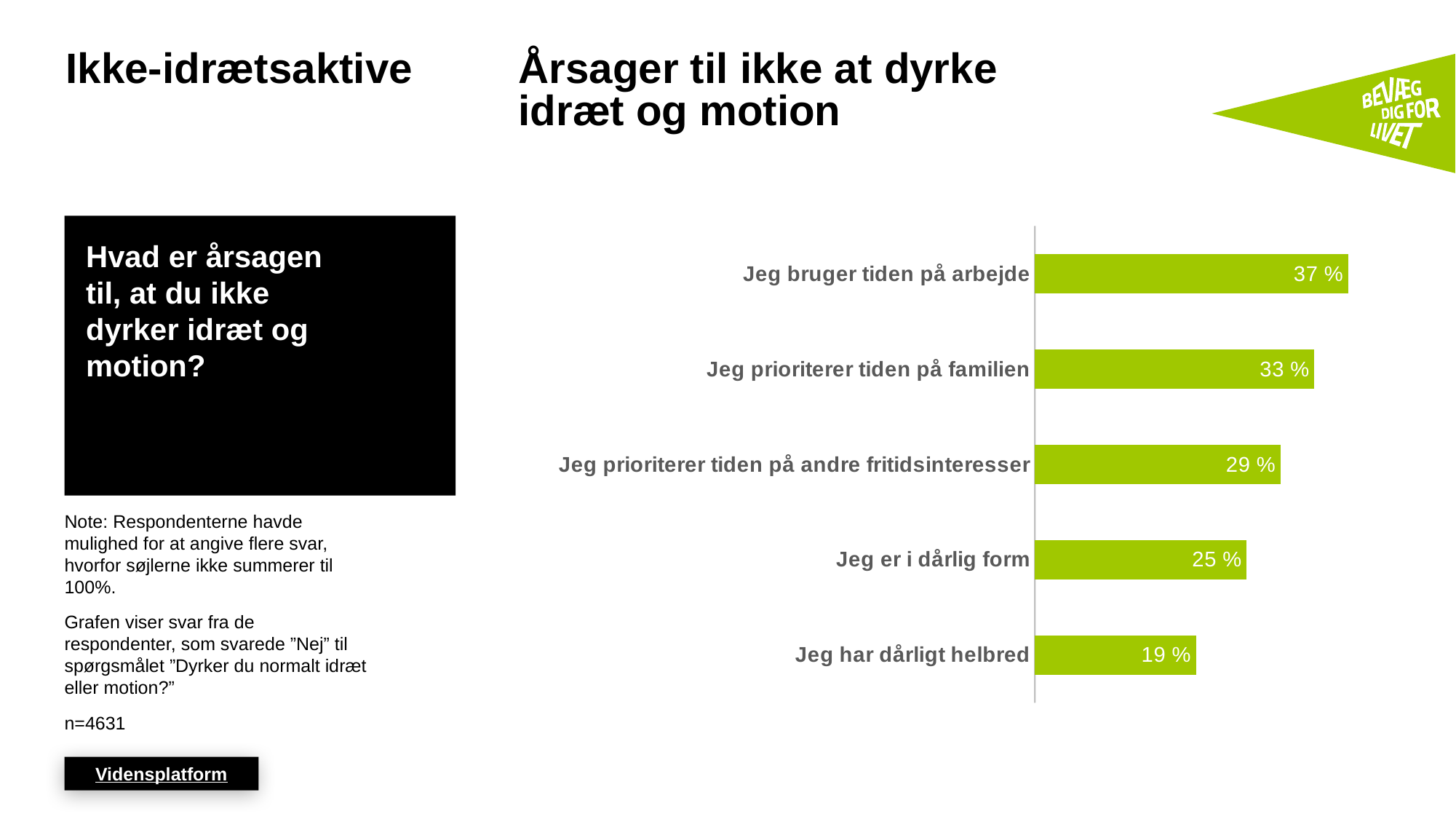
What colour are the bars in the chart? Green How many reasons (categories) are shown in the chart? 5 What is the value for "Jeg har dårligt helbred"? 19 % What is the difference between the highest and lowest values in the chart? 18 % Which reason has the lowest percentage? Jeg har dårligt helbred What is the value for "Jeg er i dårlig form"? 25 % Which reason has the highest percentage? Jeg bruger tiden på arbejde Which is larger: "Jeg er i dårlig form" or "Jeg har dårligt helbred"? Jeg er i dårlig form What percentage of respondents answered "Jeg bruger tiden på arbejde"? 37 % What is the title of the chart on the slide? Årsager til ikke at dyrke idræt og motion What type of chart is shown on the slide? Bar chart What is the difference between "Jeg prioriterer tiden på familien" and "Jeg prioriterer tiden på andre fritidsinteresser"? 4 %